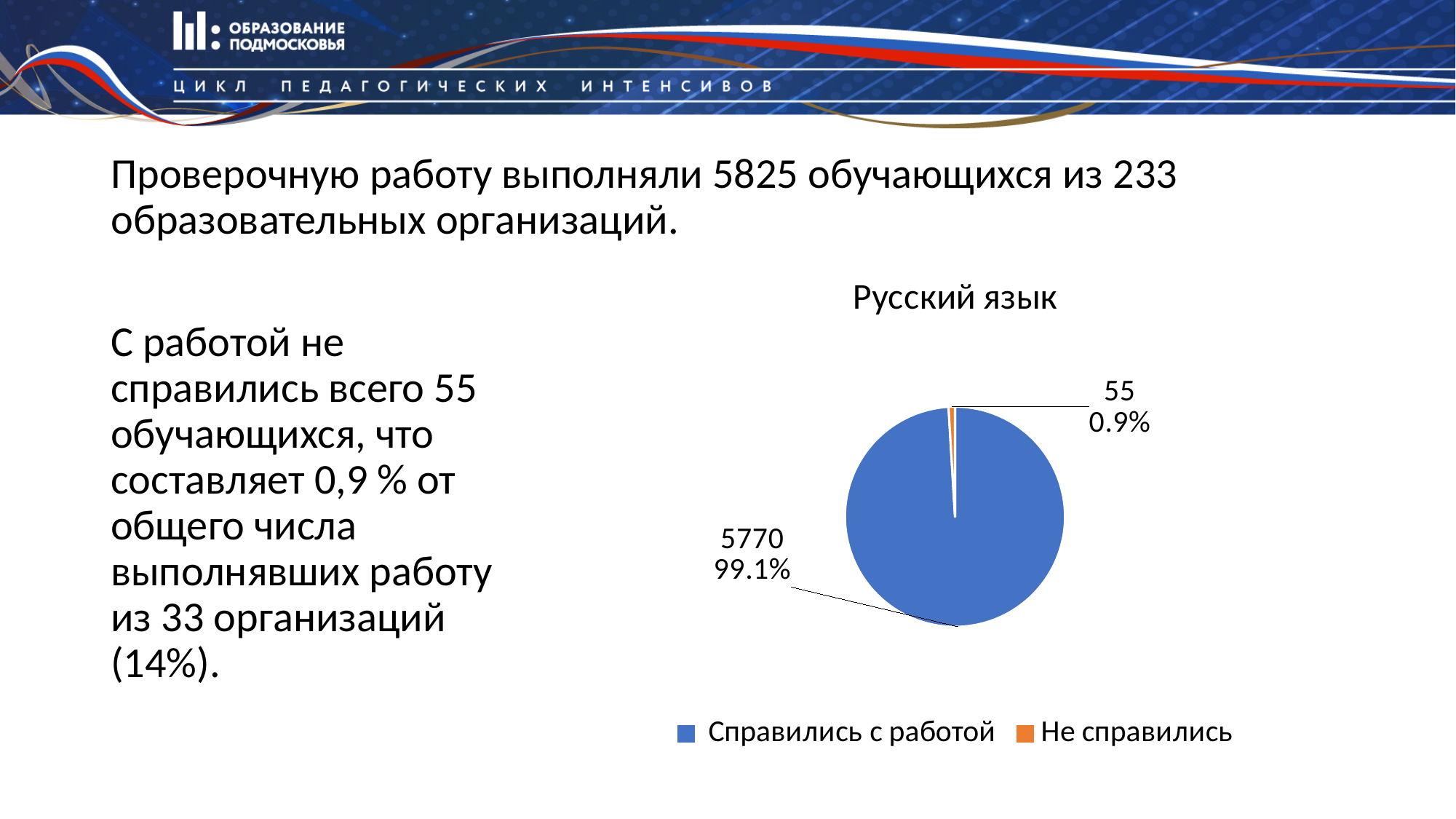
What is the value for "Не справились"? 55 What kind of chart is shown on the slide? Pie chart What is the title of the chart? Русский язык Which slice is the largest? Справились с работой How many slices does the pie chart have? 2 Which slice is the smallest? Не справились What colour is the "Не справились" slice? Orange What is the difference between the values for "Справились с работой" and "Не справились"? 5715 What share of the pie does "Справились с работой" represent? 99.1% What is the value for "Справились с работой"? 5770 How many entries does the legend list? 2 What share of the pie does "Не справились" represent? 0.9%